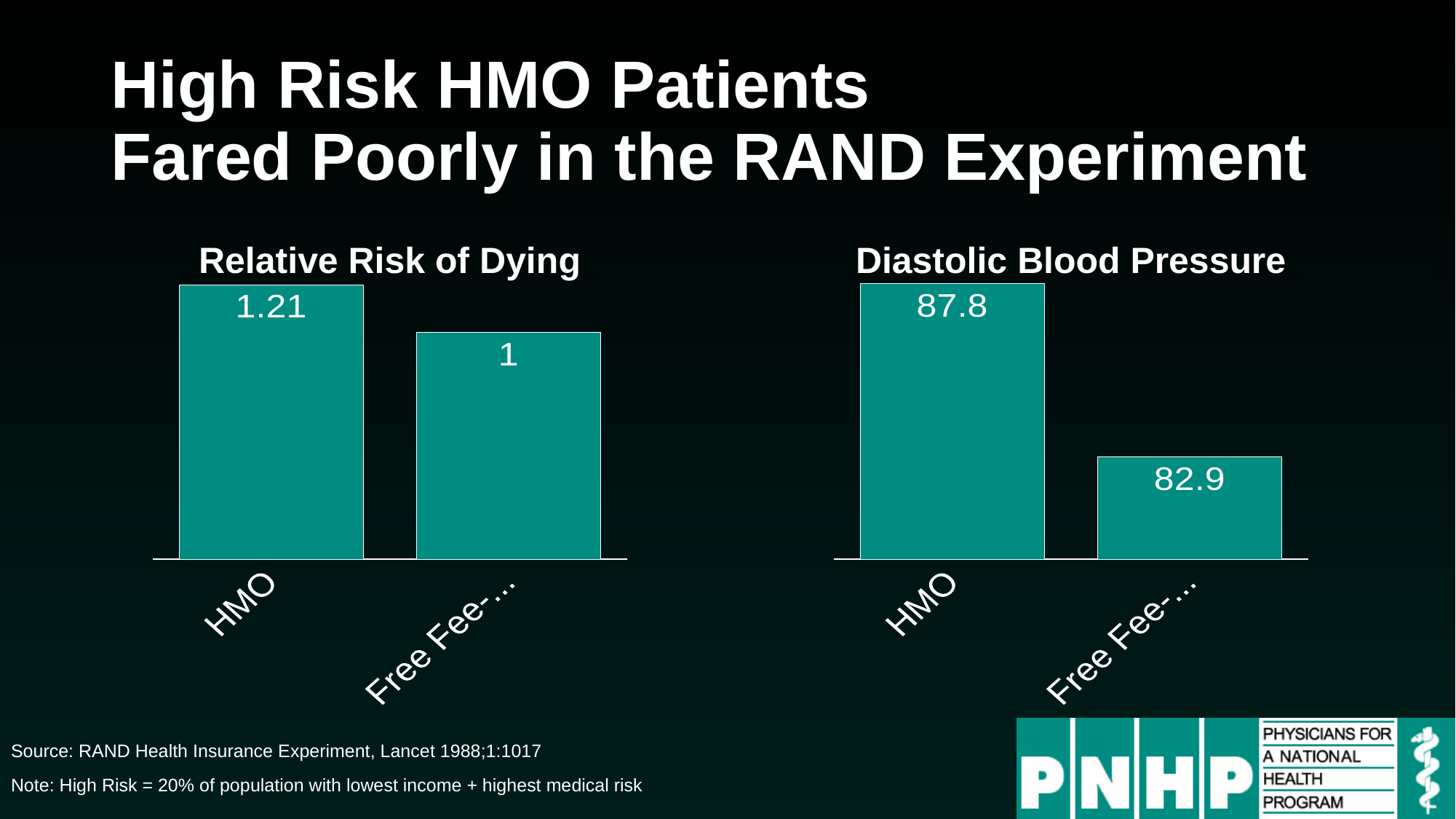
In the 'Diastolic Blood Pressure' chart, what is the value for the second bar (labelled 'Free Fee-…')? 82.9 In the 'Diastolic Blood Pressure' chart, what is the difference between the HMO value and the second bar's value? 4.9 In the 'Relative Risk of Dying' chart, which category has the highest value? HMO In the 'Diastolic Blood Pressure' chart, which is larger: the HMO value or the second bar's value? HMO In the 'Relative Risk of Dying' chart, what is the value for HMO? 1.21 In the 'Diastolic Blood Pressure' chart, which category has the lowest value? Free Fee-… What type of chart is the 'Diastolic Blood Pressure' chart? Bar chart What is the title of the chart on the left side of the slide? Relative Risk of Dying In the 'Diastolic Blood Pressure' chart, what is the value for HMO? 87.8 In the 'Relative Risk of Dying' chart, what is the difference between the HMO value and the second bar's value? 0.21 In the 'Relative Risk of Dying' chart, what is the value for the second bar (labelled 'Free Fee-…')? 1 How many bars are in the 'Relative Risk of Dying' chart? 2